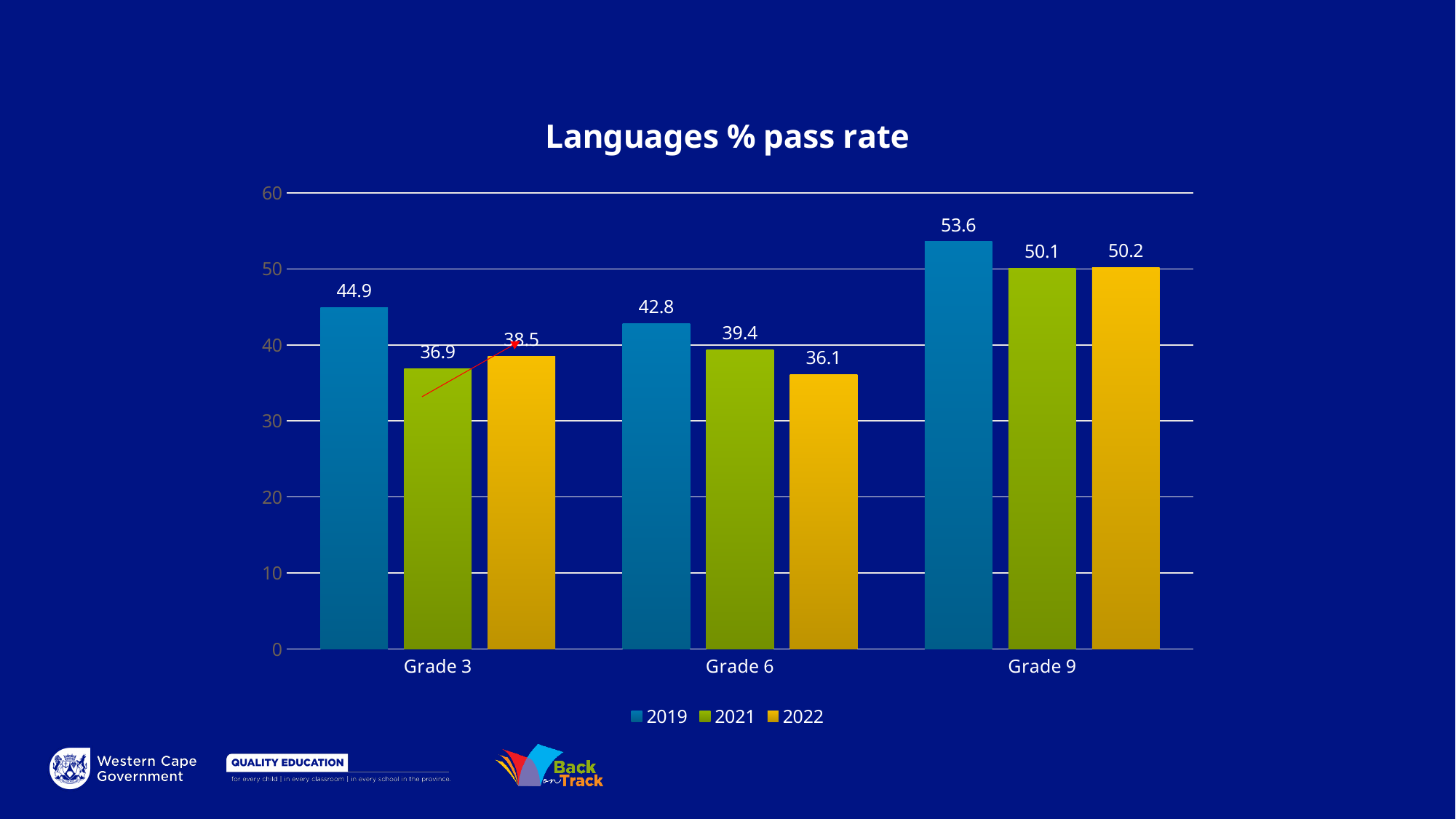
What kind of chart is shown on the slide? Bar chart What is the 2019 Languages pass rate for Grade 3? 44.9 Is the 2019 Languages pass rate for Grade 9 greater or less than 50? greater What is the difference between the 2019 and 2021 Languages pass rates for Grade 9? 3.5 How many series does the legend list? 3 What is the difference between the 2019 and 2022 Languages pass rates for Grade 3? 6.4 Which grade has the lowest 2022 Languages pass rate? Grade 6 How many grades are shown on the x axis of the chart? 3 What is the 2021 Languages pass rate for Grade 9? 50.1 Which is larger for Grade 6: the 2021 pass rate or the 2022 pass rate? 2021 Which grade has the highest 2019 Languages pass rate? Grade 9 What is the 2022 Languages pass rate for Grade 6? 36.1